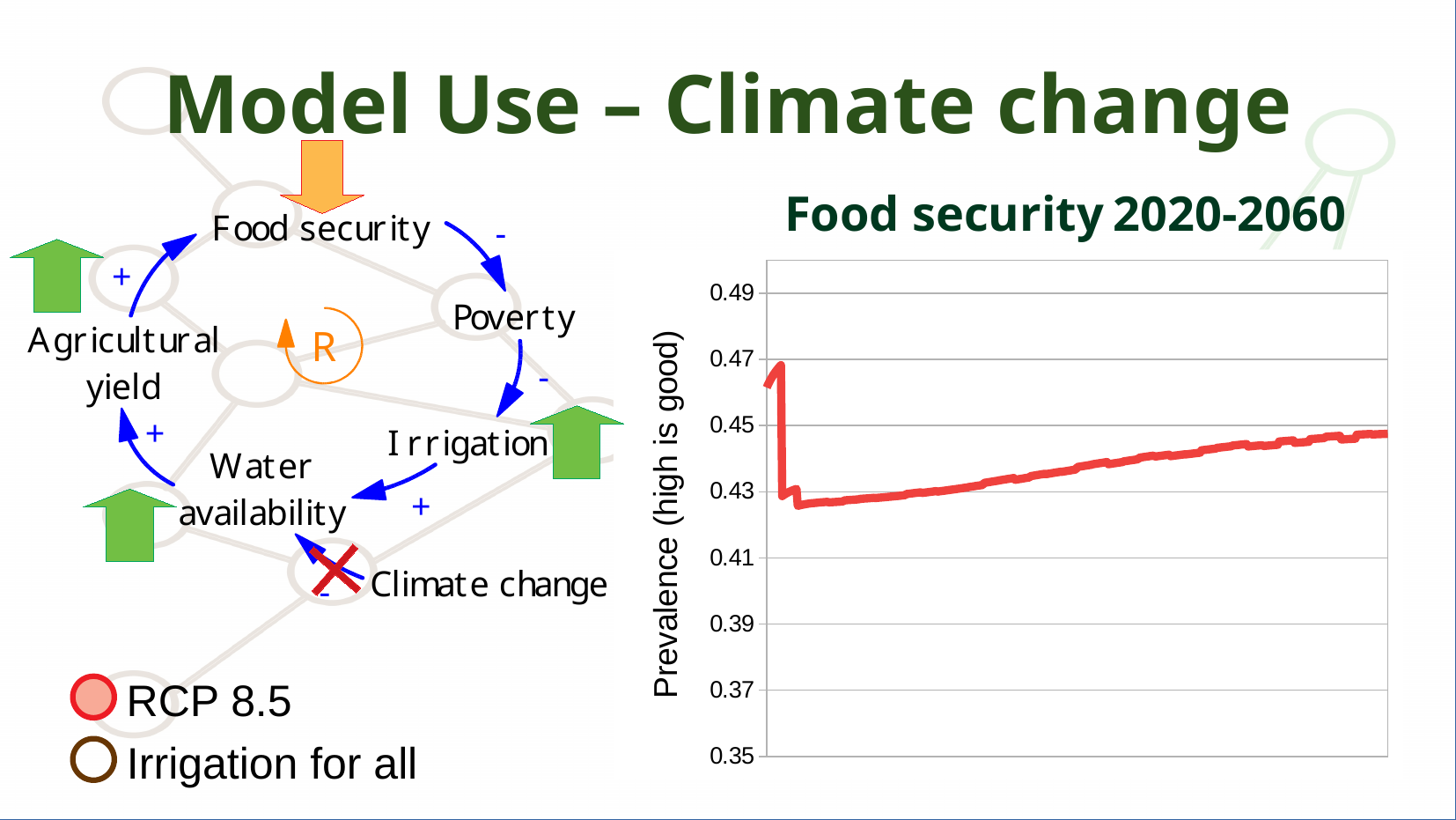
On the 'Food security 2020-2060' chart, what is the highest value shown on the y axis? 0.49 What kind of chart is shown under the title 'Food security 2020-2060'? line chart On the 'Food security 2020-2060' chart, after the initial sharp drop, does the line rise or fall over the rest of the period? rise On the 'Food security 2020-2060' chart, is the value at the end of the line greater or less than 0.43? greater How many lines are plotted on the 'Food security 2020-2060' chart? 1 On the 'Food security 2020-2060' chart, is the value at the end of the line greater or less than the value at the very start? less On the 'Food security 2020-2060' chart, what is the lowest value shown on the y axis? 0.35 What is the label of the y axis on the 'Food security 2020-2060' chart? Prevalence (high is good) On the 'Food security 2020-2060' chart, is the lowest point of the line greater or less than 0.45? less On the 'Food security 2020-2060' chart, is the value at the very start of the line greater or less than 0.45? greater What is the title of the chart on the right of the slide? Food security 2020-2060